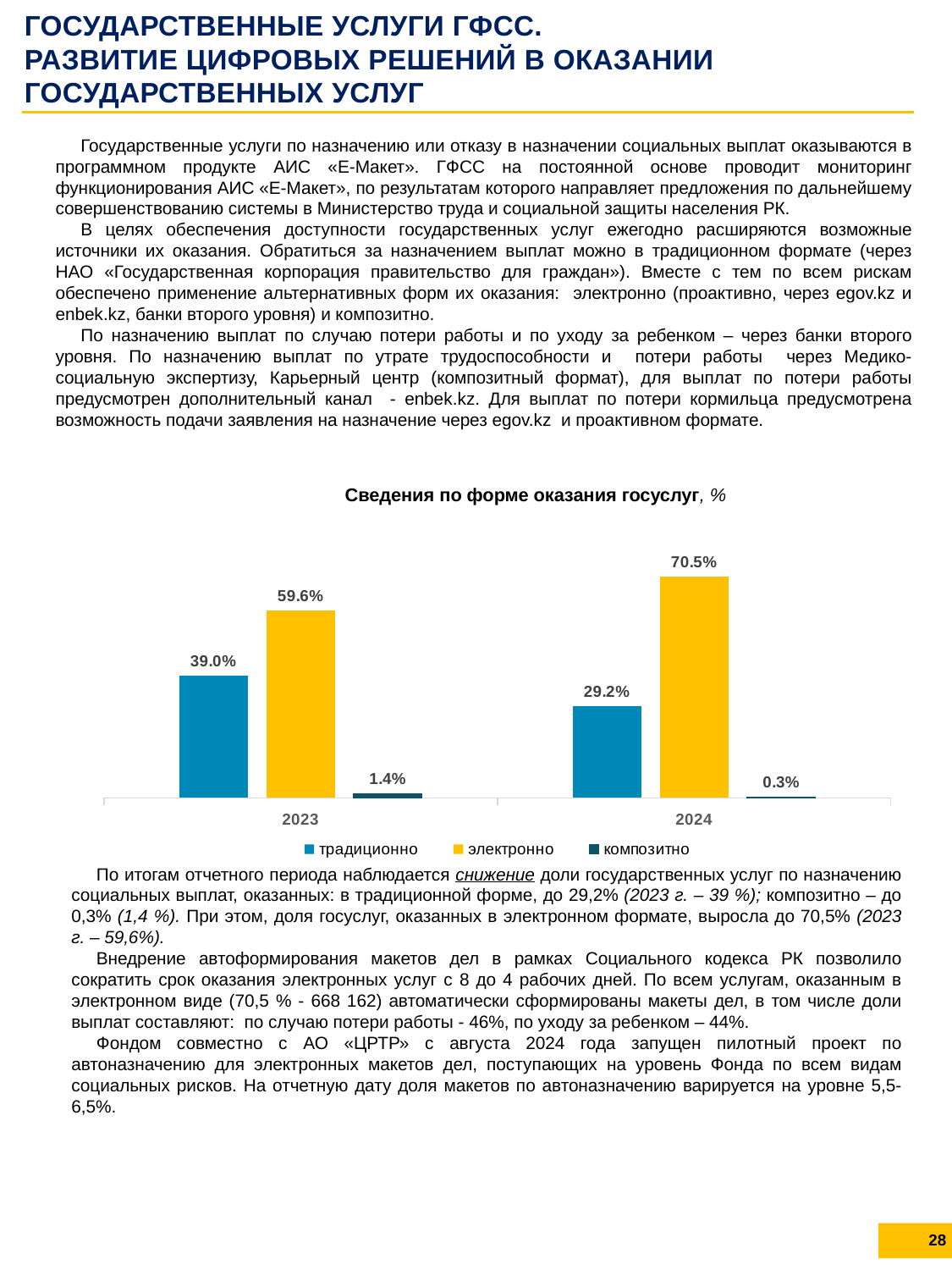
Which series has the highest value in 2024? электронно Does the value for композитно rise or fall from 2023 to 2024? fall Which series has the lowest value in 2023? композитно What is the value for традиционно in 2023? 39.0% What is the difference between традиционно in 2023 and традиционно in 2024? 9.8 What is the value for электронно in 2023? 59.6% What is the value for композитно in 2024? 0.3% How many series does the legend list? 3 What kind of chart is shown on the slide? bar chart What is the value for электронно in 2024? 70.5% Which is larger: традиционно in 2023 or традиционно in 2024? традиционно in 2023 By how many percentage points did the value for электронно change from 2023 to 2024? 10.9